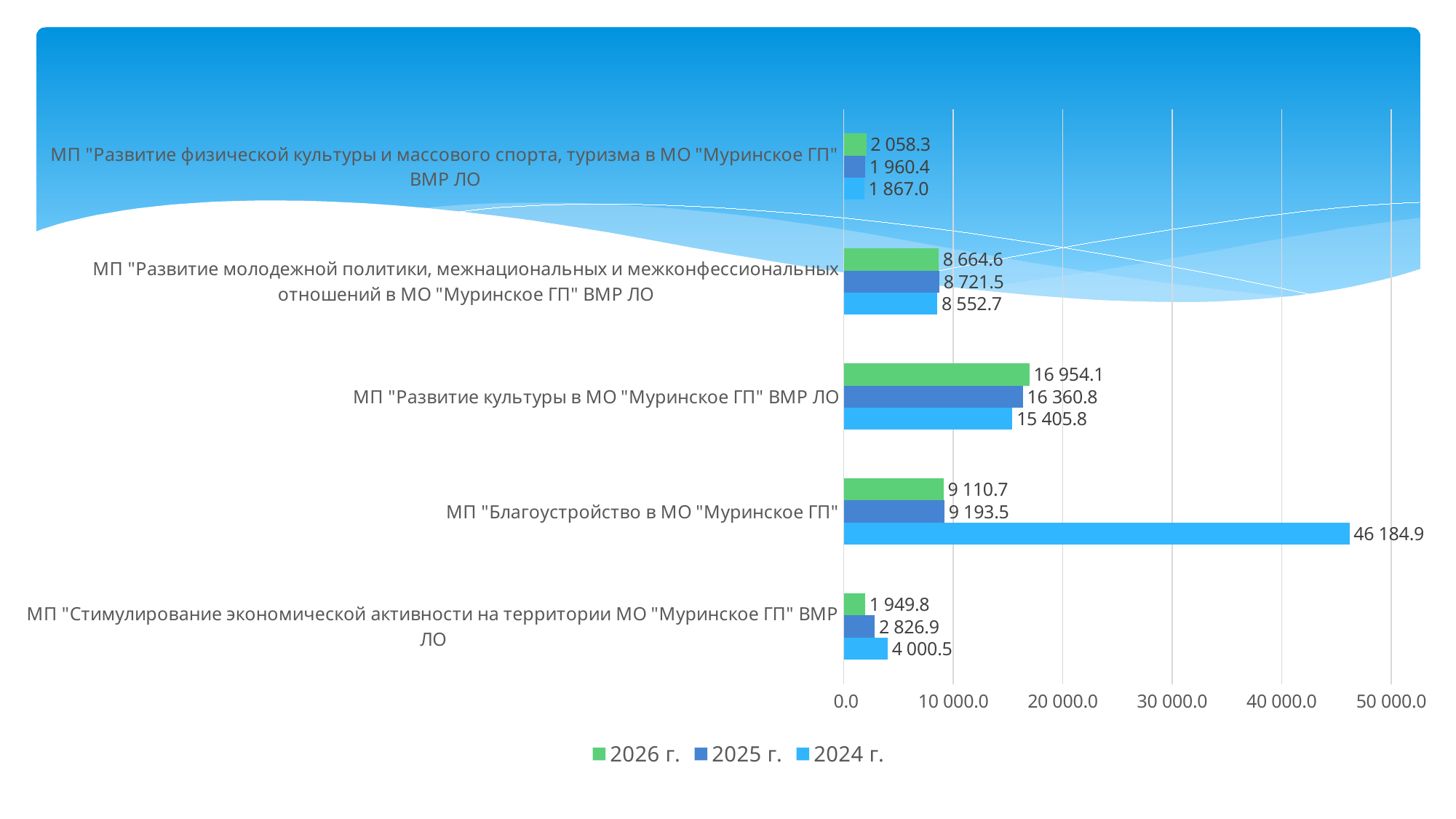
What is the 2026 г. value for МП "Развитие культуры в МО "Муринское ГП" ВМР ЛО"? 16 954.1 What is the difference between the 2026 г. and 2024 г. values for МП "Развитие культуры в МО "Муринское ГП" ВМР ЛО"? 1 548.3 Which programme has the highest 2024 г. value? МП "Благоустройство в МО "Муринское ГП"" How many programmes (categories) are shown on the chart? 5 What is the 2024 г. value for МП "Развитие физической культуры и массового спорта, туризма в МО "Муринское ГП" ВМР ЛО"? 1 867.0 What is the 2024 г. value for МП "Благоустройство в МО "Муринское ГП""? 46 184.9 For МП "Стимулирование экономической активности на территории МО "Муринское ГП" ВМР ЛО", which is larger: the 2024 г. value or the 2026 г. value? 2024 г. Which programme has the lowest 2026 г. value? МП "Стимулирование экономической активности на территории МО "Муринское ГП" ВМР ЛО" What is the difference between the 2024 г. and 2025 г. values for МП "Благоустройство в МО "Муринское ГП""? 36 991.4 What kind of chart is shown on the slide? Bar chart How many series does the legend list? 3 What is the 2025 г. value for МП "Стимулирование экономической активности на территории МО "Муринское ГП" ВМР ЛО"? 2 826.9